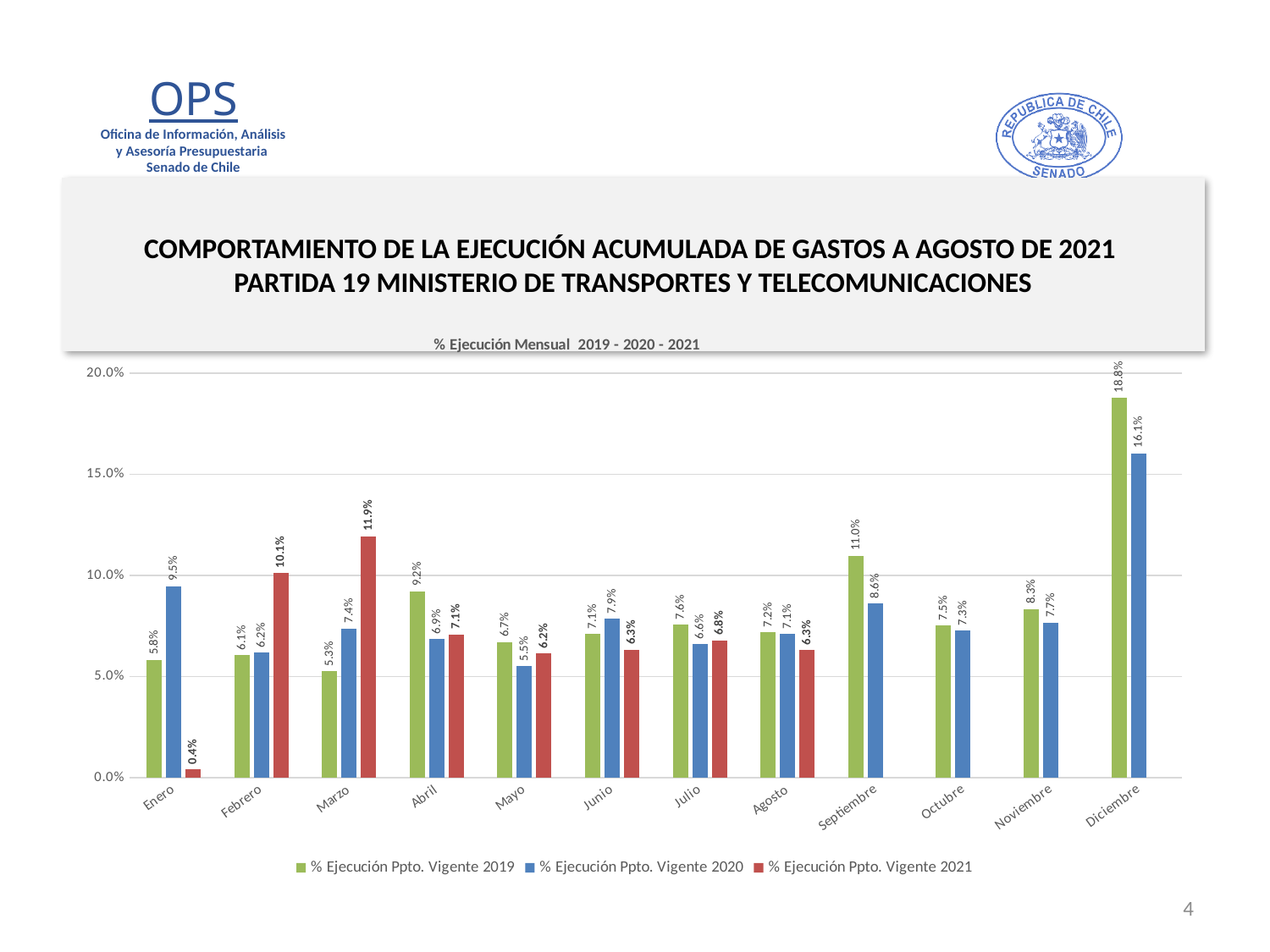
Is the value for % Ejecución Ppto. Vigente 2019 in Septiembre greater or less than 10.0%? greater What is the difference between the 2019 and 2020 values in Diciembre? 2.7% How many months are shown on the x axis? 12 Which month has the lowest value for % Ejecución Ppto. Vigente 2021? Enero What is the value for % Ejecución Ppto. Vigente 2021 in Marzo? 11.9% What is the value for % Ejecución Ppto. Vigente 2021 in Enero? 0.4% What is the value for % Ejecución Ppto. Vigente 2020 in Enero? 9.5% What is the value for % Ejecución Ppto. Vigente 2019 in Diciembre? 18.8% How many series does the legend list? 3 In Abril, which series has the larger value: % Ejecución Ppto. Vigente 2019 or % Ejecución Ppto. Vigente 2020? % Ejecución Ppto. Vigente 2019 What kind of chart is shown on the slide? Bar chart Which month has the highest value for % Ejecución Ppto. Vigente 2019? Diciembre